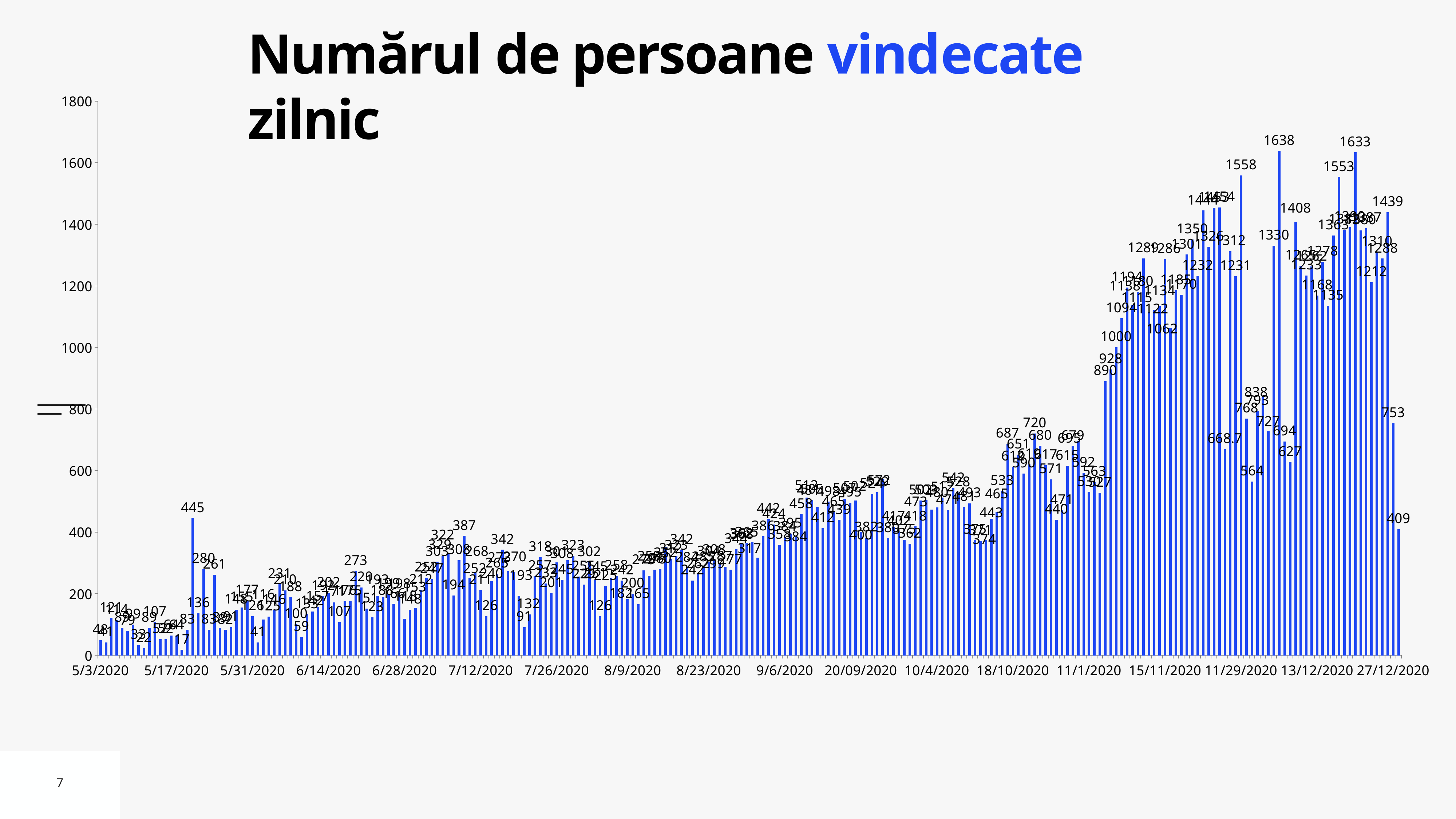
What kind of chart is shown on the slide? bar chart What is the highest daily value shown on the chart? 1638 Which is larger: the May peak labelled 445 or the July peak labelled 387? 445 What is the lowest daily value labelled on the chart? 17 Is the highest bar on the chart greater or less than 1600? greater Overall, do the daily values rise or fall from May 2020 to December 2020? rise What is the difference between the highest value (1638) and the last bar's value (409)? 1229 What colour are the bars on the chart? blue What is the difference between the two tallest bars, labelled 1638 and 1633? 5 What is the title of the chart? Numărul de persoane vindecate zilnic Which is larger: the bar labelled 1638 or the bar labelled 1558? 1638